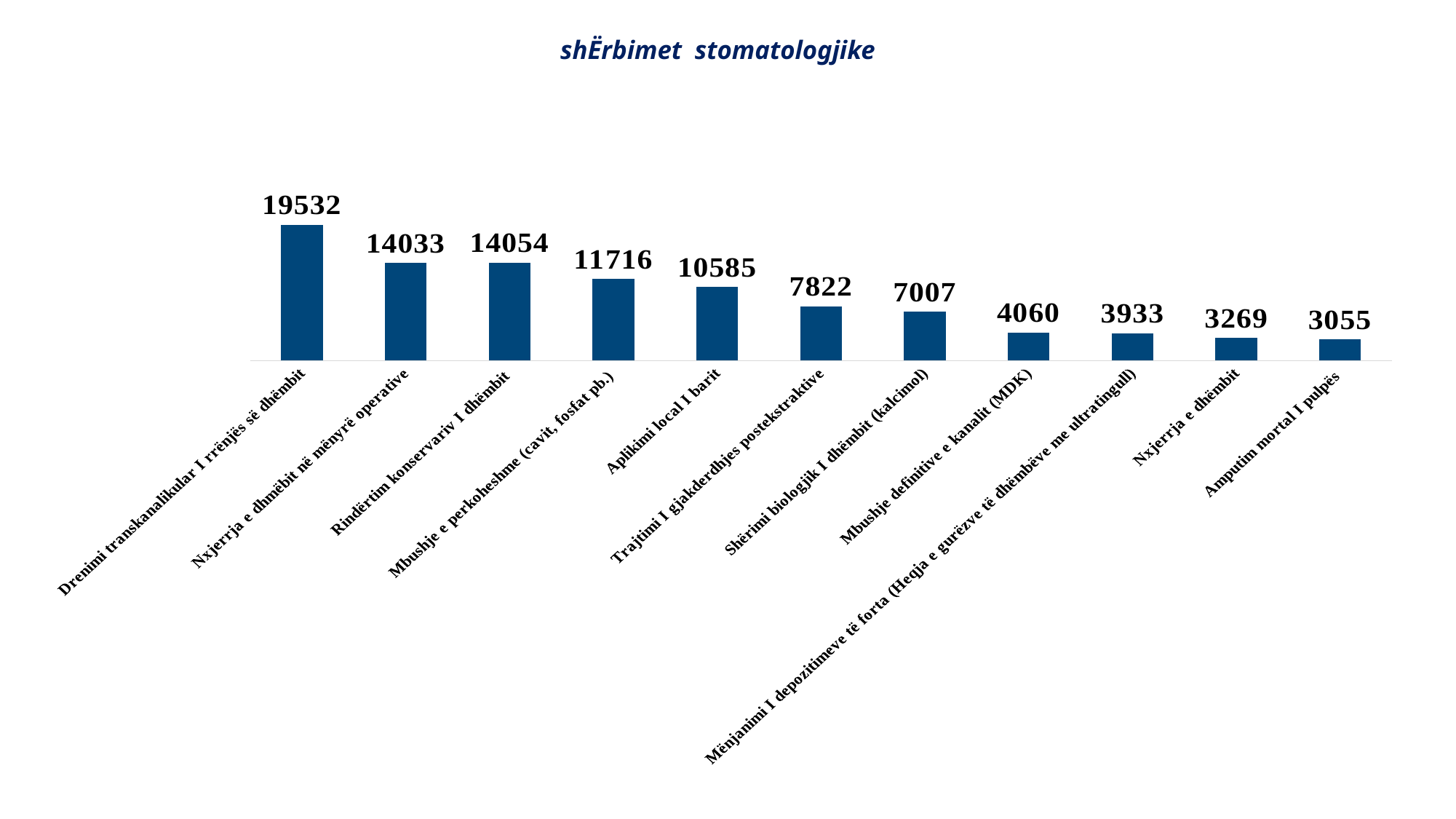
What kind of chart is shown on the slide? Bar chart What is the value for Drenimi transkanalikular I rrënjës së dhëmbit? 19532 What is the difference between the values for Drenimi transkanalikular I rrënjës së dhëmbit and Rindërtim konservariv I dhëmbit? 5478 How many categories are shown in the chart? 11 Which category has the highest value? Drenimi transkanalikular I rrënjës së dhëmbit What is the value for Amputim mortal I pulpës? 3055 Which is larger, the value for Mbushje e perkoheshme (cavit, fosfat pb.) or the value for Aplikimi local I barit? Mbushje e perkoheshme (cavit, fosfat pb.) What is the difference between the values for Trajtimi I gjakderdhjes postekstraktive and Shërimi biologjik I dhëmbit (kalcimol)? 815 What is the value for Mbushje definitive e kanalit (MDK)? 4060 What is the value for Aplikimi local I barit? 10585 Which category has the lowest value? Amputim mortal I pulpës What is the title of the chart? shËrbimet stomatologjike